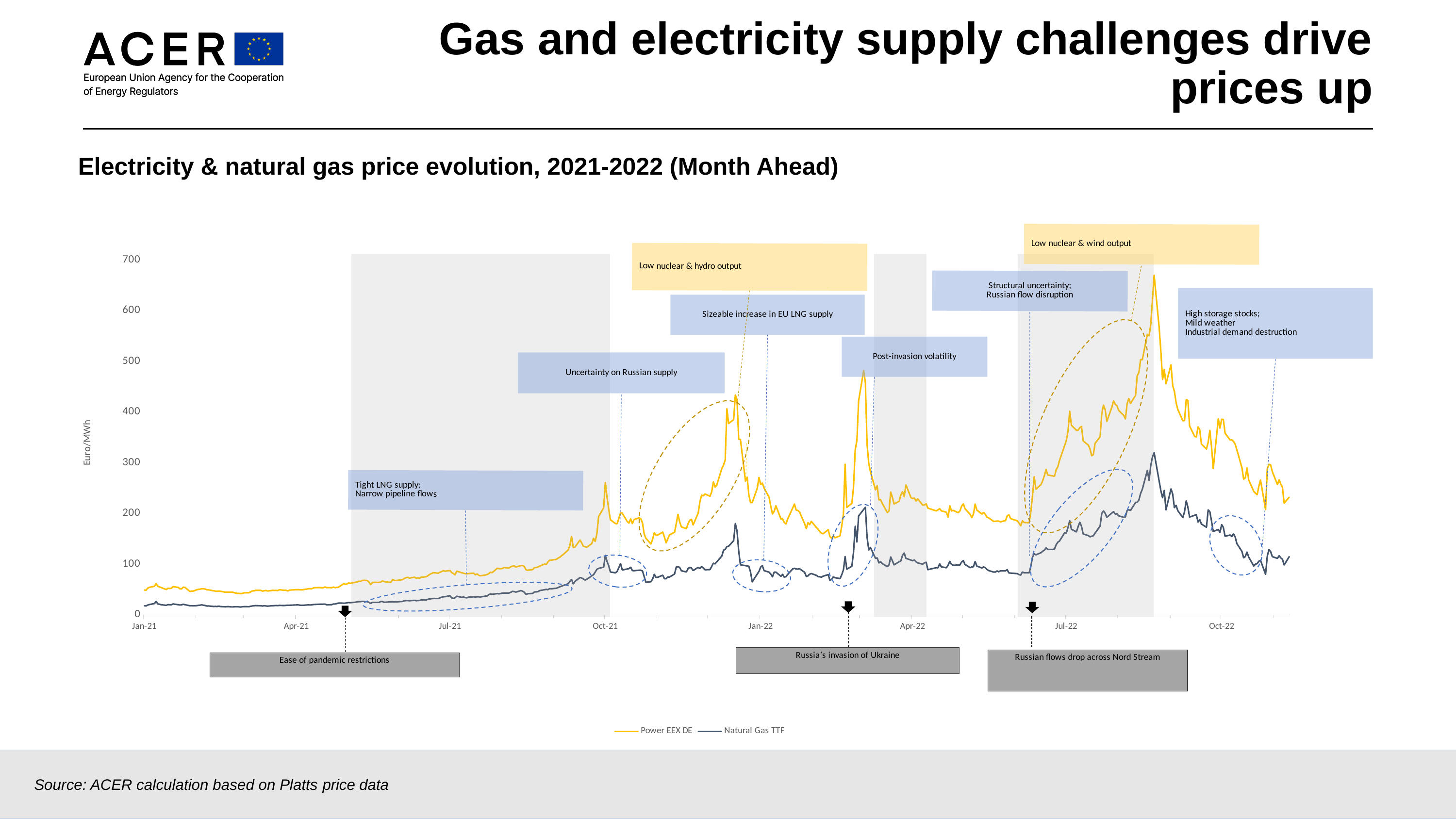
What kind of chart is shown on the slide? Line chart Is the value of Power EEX DE at Jan-21 greater or less than 100? less What is the label on the vertical axis? Euro/MWh Do the Power EEX DE values rise or fall between Jan-21 and Oct-21? rise What are the two series named in the legend? Power EEX DE and Natural Gas TTF Which series reaches the higher peak value, Power EEX DE or Natural Gas TTF? Power EEX DE Is the value of Natural Gas TTF at Jan-21 greater or less than 100? less Do the Power EEX DE values rise or fall between Oct-22 and the end of the series? fall Is the highest value reached by Natural Gas TTF greater or less than 400? less How many series does the legend list? 2 How many date labels are shown on the horizontal axis? 8